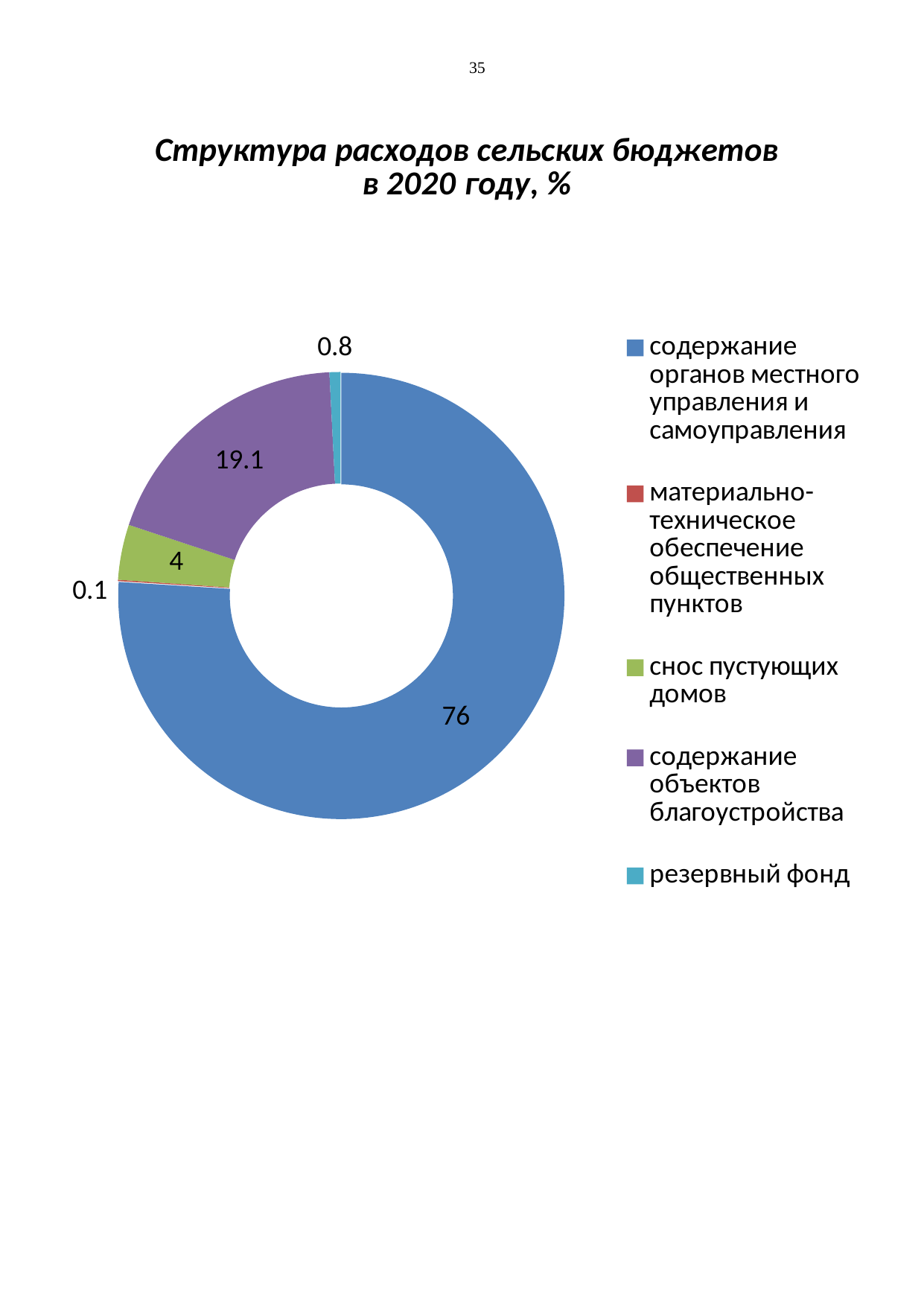
What is the value for содержание объектов благоустройства? 19.1 Which is larger, снос пустующих домов or резервный фонд? снос пустующих домов What is the value for материально-техническое обеспечение общественных пунктов? 0.1 Which category has the smallest share? материально-техническое обеспечение общественных пунктов What is the title of the chart? Структура расходов сельских бюджетов в 2020 году, % What is the value for резервный фонд? 0.8 How many categories does the chart show? 5 What is the value for снос пустующих домов? 4 Which category has the largest share? содержание органов местного управления и самоуправления What is the value for содержание органов местного управления и самоуправления? 76 What is the difference between the values for содержание органов местного управления и самоуправления and содержание объектов благоустройства? 56.9 What kind of chart is shown on the slide? pie chart (doughnut)